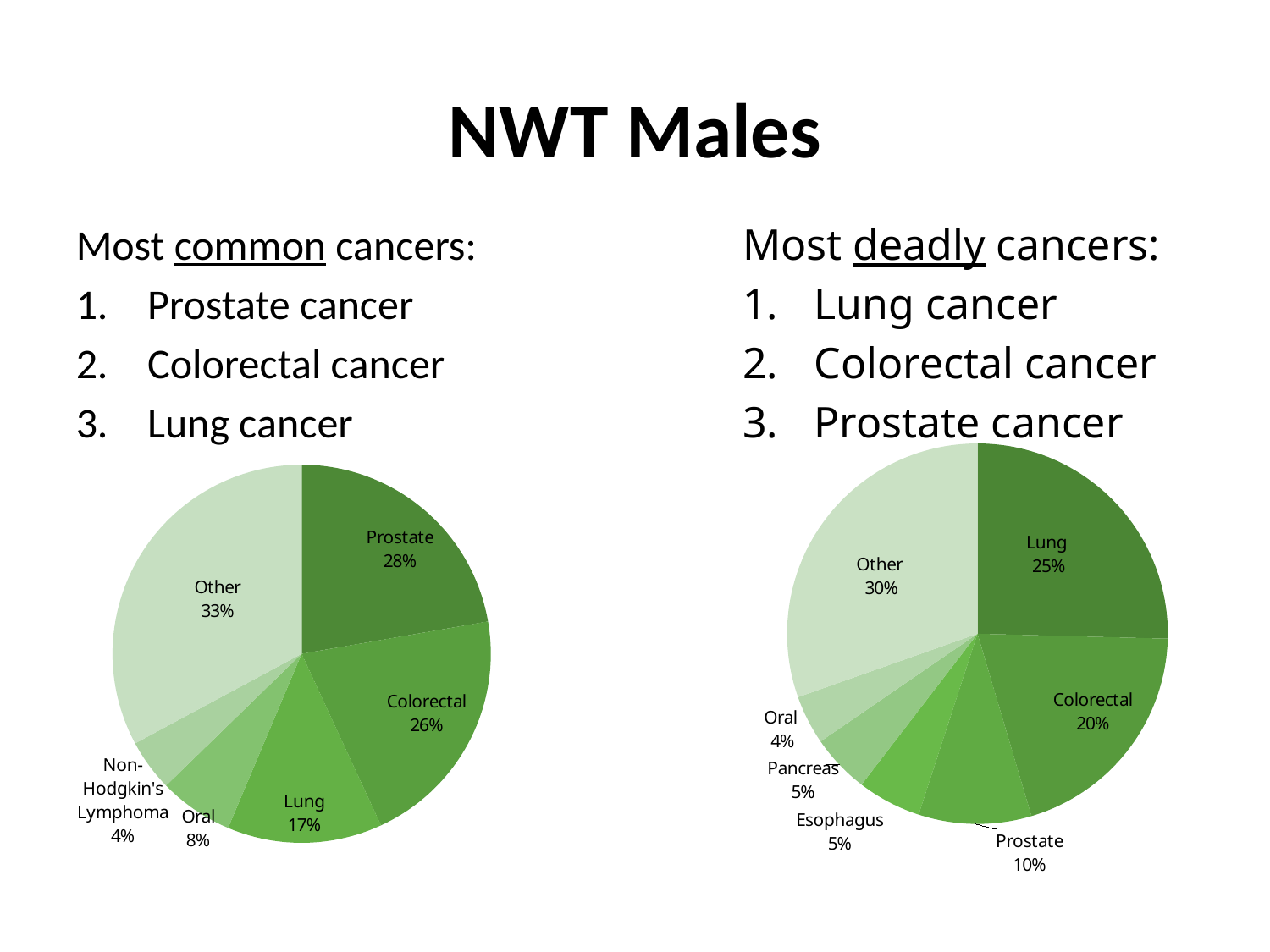
How many slices does the right pie chart have? 7 In the right pie chart, what is the difference between the Lung and Prostate percentages? 15% In the right pie chart, what percentage is shown for Esophagus? 5% In the right pie chart, which slice is the smallest? Oral In the left pie chart, which named cancer type (excluding Other) has the largest slice? Prostate In the right pie chart (most deadly cancers), what percentage is shown for Lung? 25% In the right pie chart, which is larger: Colorectal or Prostate? Colorectal What type of chart is used on this slide? Pie chart In the left pie chart (most common cancers), what percentage is shown for Prostate? 28% In the left pie chart, what percentage is shown for Non-Hodgkin's Lymphoma? 4% How many slices does the left pie chart have? 6 In the left pie chart, what is the difference between the Colorectal and Lung percentages? 9%